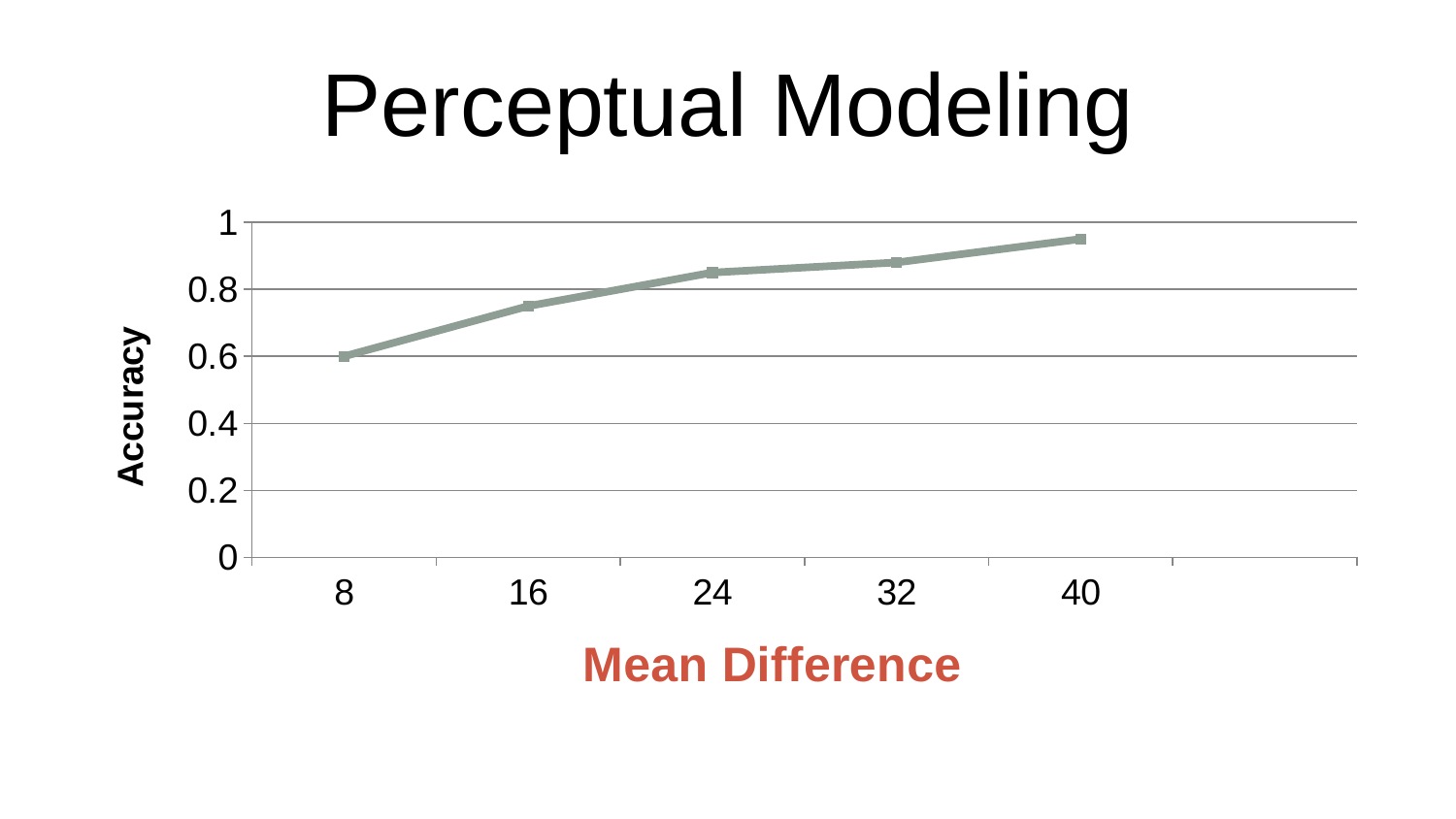
What is the label of the x axis? Mean Difference Which has the higher accuracy, a mean difference of 8 or a mean difference of 40? 40 What is the label of the y axis? Accuracy At which mean difference is accuracy highest? 40 What kind of chart is shown on the slide? line chart Does accuracy rise or fall as mean difference increases along the x axis? rise Is the accuracy at a mean difference of 24 greater or less than 0.8? greater What is the accuracy at a mean difference of 8? 0.6 Is the accuracy at a mean difference of 16 greater or less than 0.8? less How many data points are plotted on the line? 5 At which mean difference is accuracy lowest? 8 Is the accuracy at a mean difference of 40 greater or less than 0.8? greater